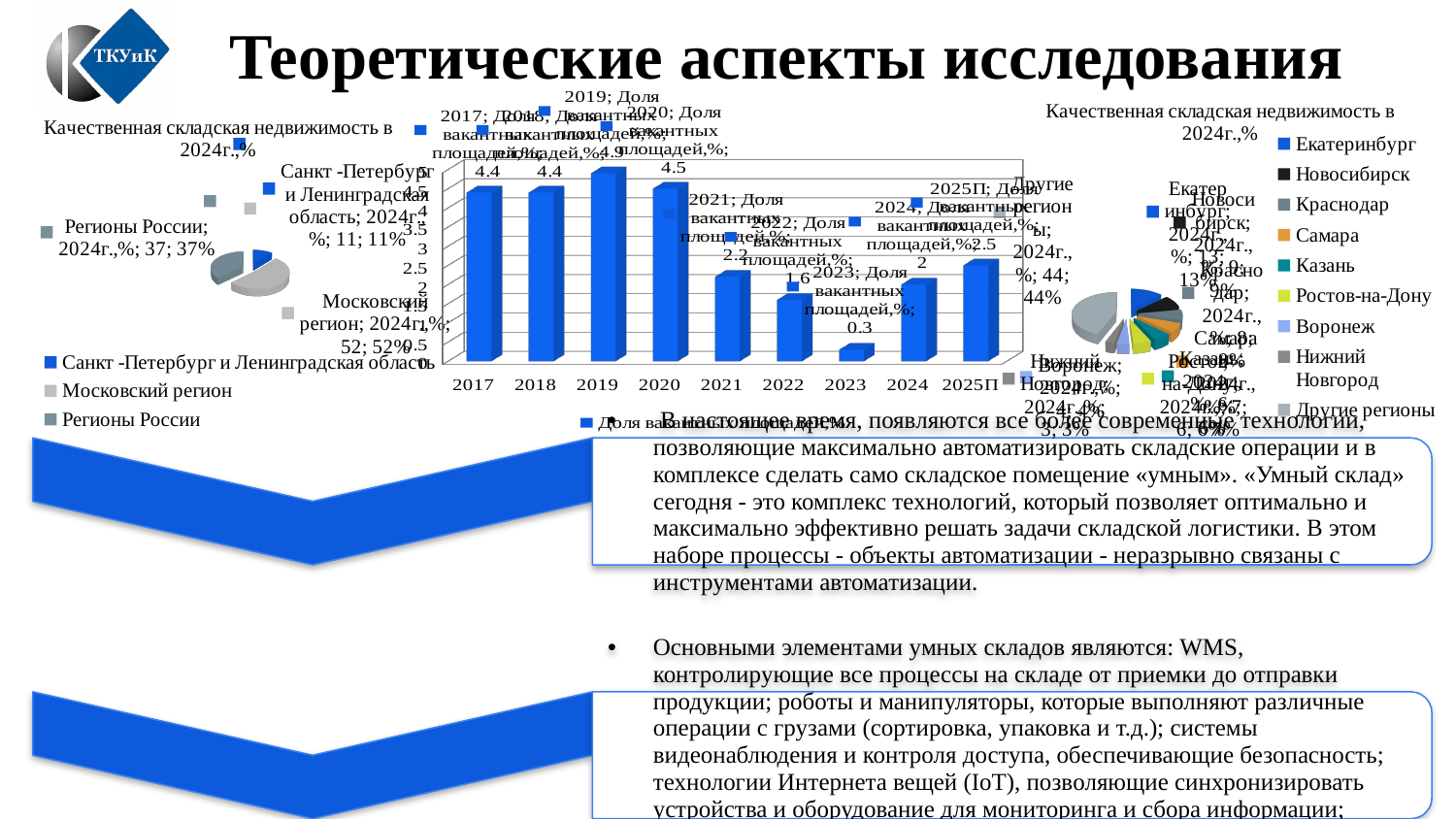
In the left pie chart 'Качественная складская недвижимость в 2024г.,%', what is the share for Регионы России? 37% In the right pie chart 'Качественная складская недвижимость в 2024г.,%', what is the share for Другие регионы? 44% In the left pie chart 'Качественная складская недвижимость в 2024г.,%', what is the share for Московский регион? 52% In the bar chart in the middle of the slide, which year has the lowest value? 2023 In the bar chart in the middle of the slide, what is the value for 2025П? 2.5 In the bar chart in the middle of the slide, which year has the highest value? 2019 What kind of chart is the chart in the middle of the slide? bar chart In the bar chart in the middle of the slide, which is larger, the value for 2024 or the value for 2021? 2021 In the bar chart in the middle of the slide, what is the difference between the values for 2020 and 2022? 2.9 In the bar chart in the middle of the slide, what is the value for 2021? 2.2 How many years (categories) are shown on the x axis of the bar chart in the middle of the slide? 9 In the bar chart in the middle of the slide, what is the value for 2023? 0.3